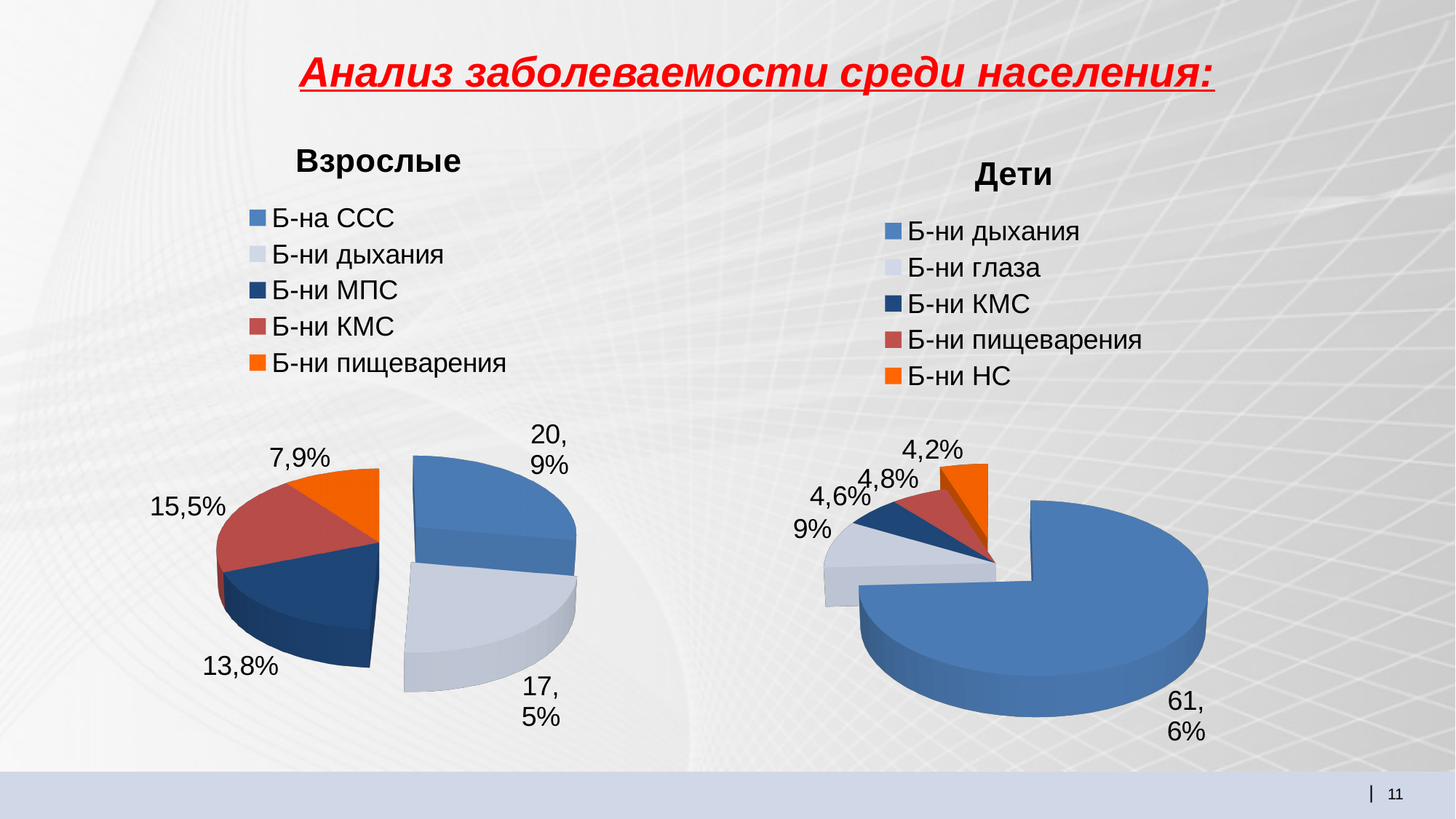
In the "Дети" chart, what colour is the Б-ни НС slice? Orange In the "Взрослые" chart, which category has the largest share? Б-на ССС In the "Взрослые" chart, what is the value for Б-на ССС? 20,9% How many categories does the "Дети" chart show? 5 In the "Дети" chart, which is larger: Б-ни пищеварения or Б-ни КМС? Б-ни пищеварения In the "Взрослые" chart, what is the difference between Б-ни КМС and Б-ни МПС? 1,7% What type of chart is the "Взрослые" chart? Pie chart In the "Дети" chart, which category has the smallest share? Б-ни НС In the "Взрослые" chart, which category has the smallest share? Б-ни пищеварения In the "Дети" chart, what is the value for Б-ни дыхания? 61,6% In the "Дети" chart, what is the value for Б-ни глаза? 9% In the "Взрослые" chart, what is the value for Б-ни пищеварения? 7,9%